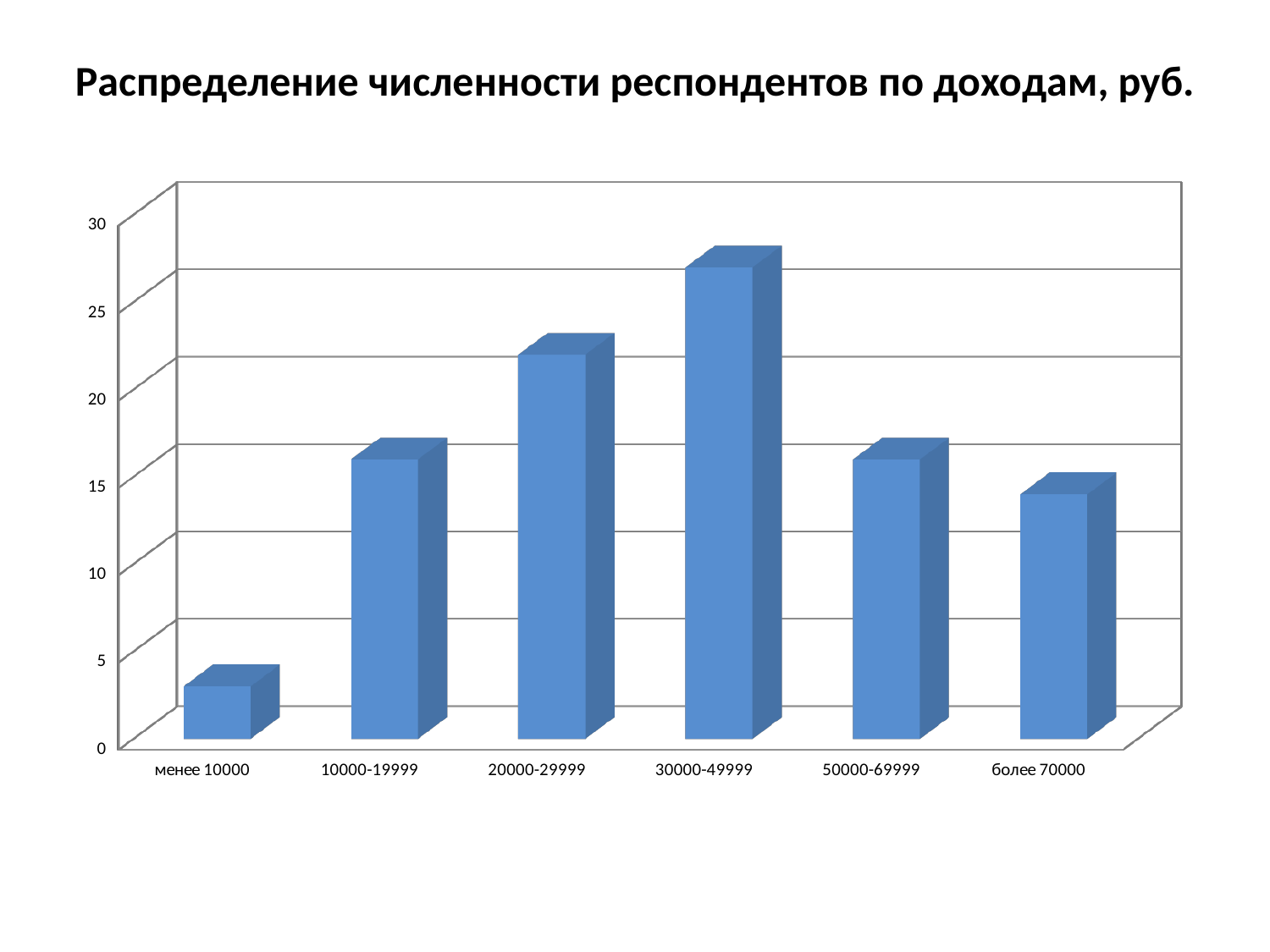
Is the value for 50000-69999 greater or less than 10? greater Which is larger, the value for 20000-29999 or the value for более 70000? 20000-29999 Which is larger, the value for 30000-49999 or the value for 20000-29999? 30000-49999 What type of chart is shown on the slide? bar chart Which income category has the highest number of respondents? 30000-49999 How many income categories are shown on the x axis? 6 Is the value for 20000-29999 greater or less than 20? greater What is the title of the chart on the slide? Распределение численности респондентов по доходам, руб. Is the value for 30000-49999 greater or less than 25? greater Which income category has the lowest number of respondents? менее 10000